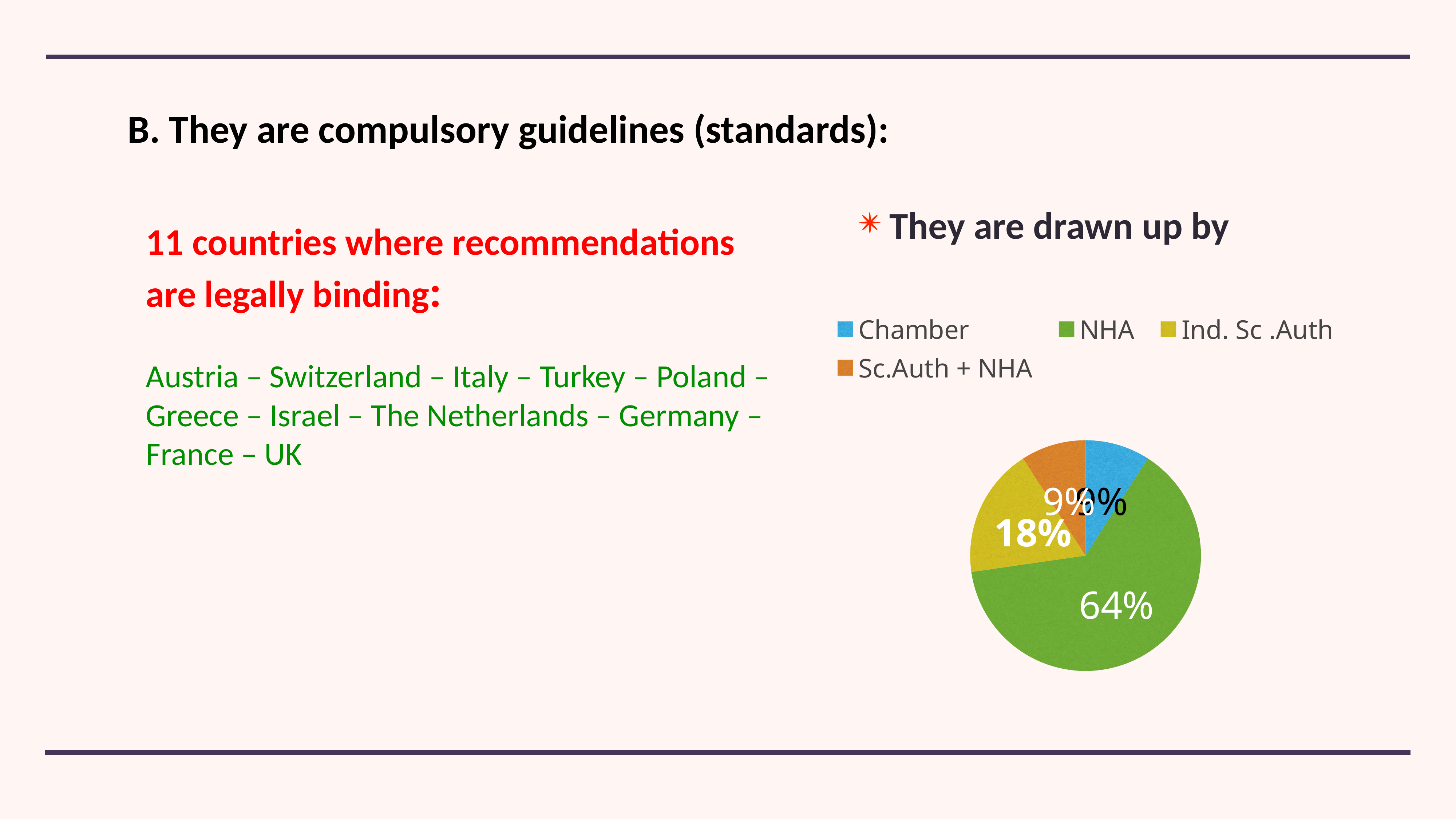
What share of the pie does Ind. Sc .Auth have? 18% What colour is the NHA slice in the pie chart? green What share of the pie does NHA have? 64% What is the difference in percentage points between the NHA slice and the Ind. Sc .Auth slice? 46% What share of the pie does Sc.Auth + NHA have? 9% What kind of chart is shown on the slide? pie chart What is the difference in percentage points between the Ind. Sc .Auth slice and the Sc.Auth + NHA slice? 9% Which category has the largest slice of the pie? NHA What is the title of the chart on the slide? They are drawn up by Which is larger, the slice for NHA or the slice for Ind. Sc .Auth? NHA How many categories does the pie chart's legend list? 4